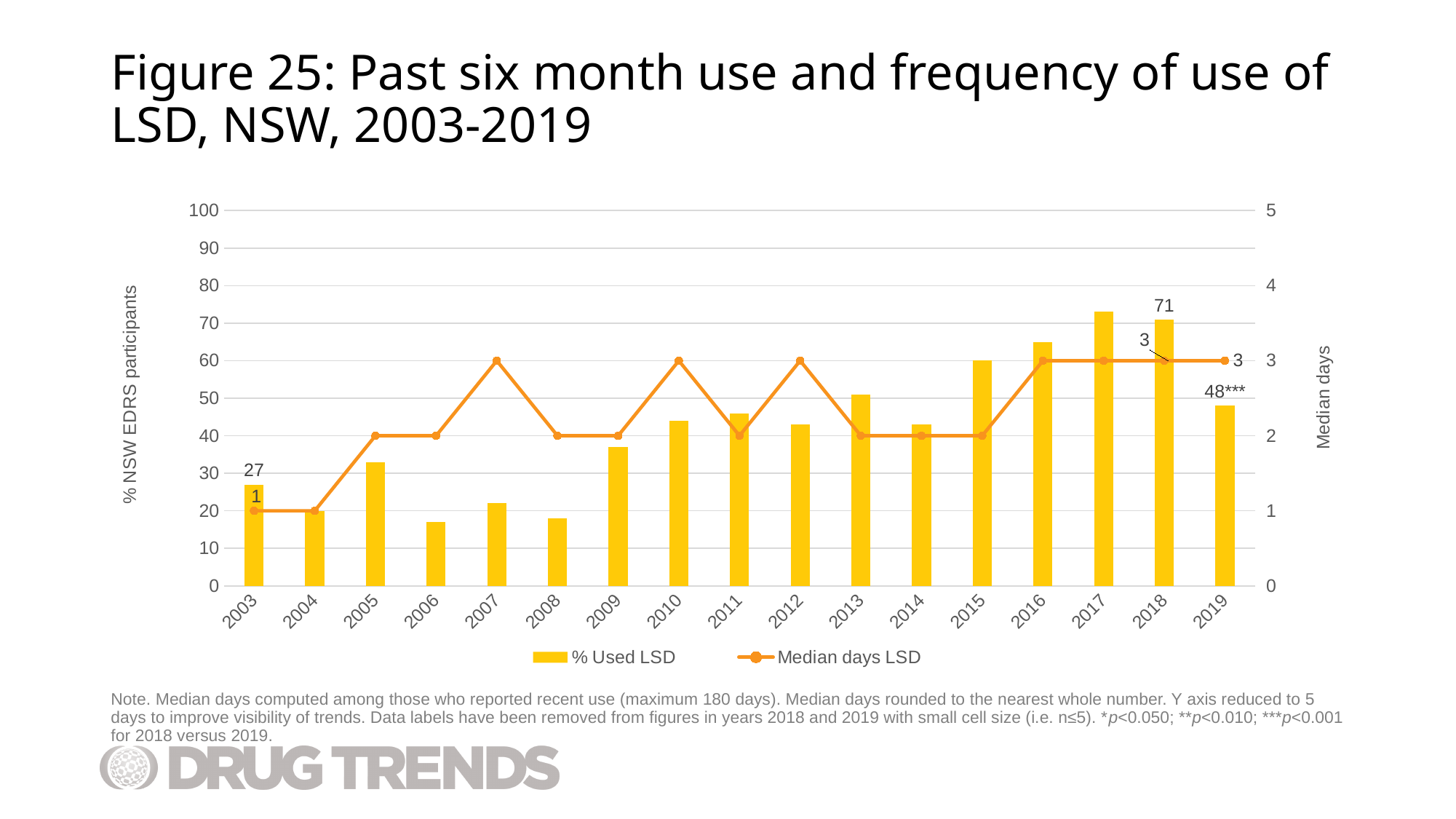
What was the median days of LSD use in 2003? 1 What is the data label shown for % Used LSD in 2019? 48*** What was the median days of LSD use in 2007? 3 Which year had a higher % Used LSD, 2018 or 2019? 2018 How many years are shown on the x axis? 17 Is the % Used LSD value for 2016 greater or less than 60? greater How many series does the legend list? 2 By how many percentage points did % Used LSD differ between 2003 and 2018? 44 Is the % Used LSD value for 2009 greater or less than 40? less What was the median days of LSD use in 2019? 3 What is the value of % Used LSD for 2018? 71 What percentage of NSW EDRS participants reported using LSD in 2003? 27